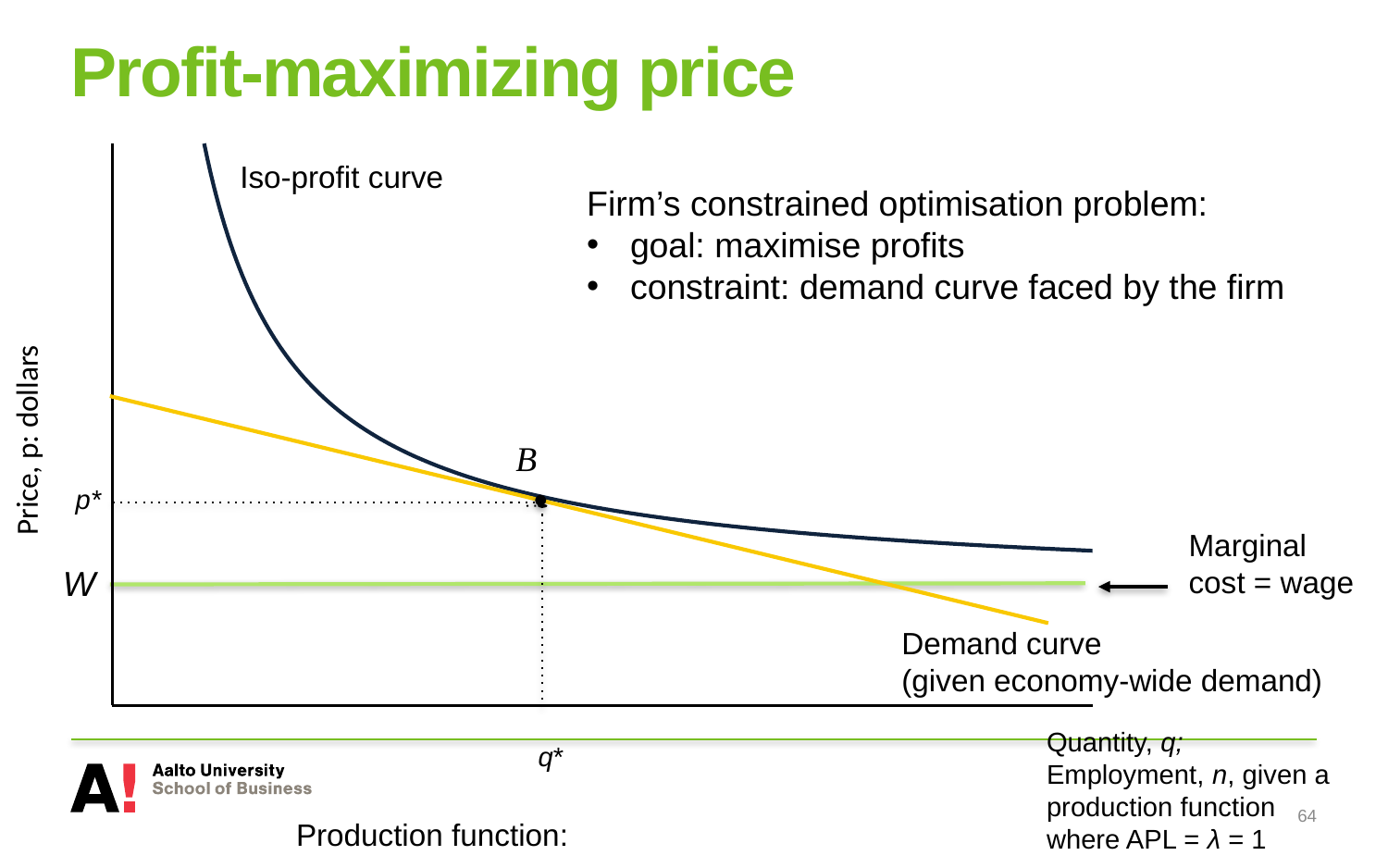
What kind of chart is shown on the slide? line chart How many curves or lines are plotted in the chart? 3 Does the iso-profit curve rise or fall as quantity increases along the x axis? fall What price label is marked on the y axis at the level of point B? p* What quantity label is marked on the x axis below point B? q* What is the label of the vertical axis? Price, p: dollars Which is higher on the price axis, p* or W? p* What does the horizontal green line at W represent? Marginal cost = wage Does the demand curve rise or fall as quantity increases along the x axis? fall What is the label of the point where the iso-profit curve touches the demand curve? B